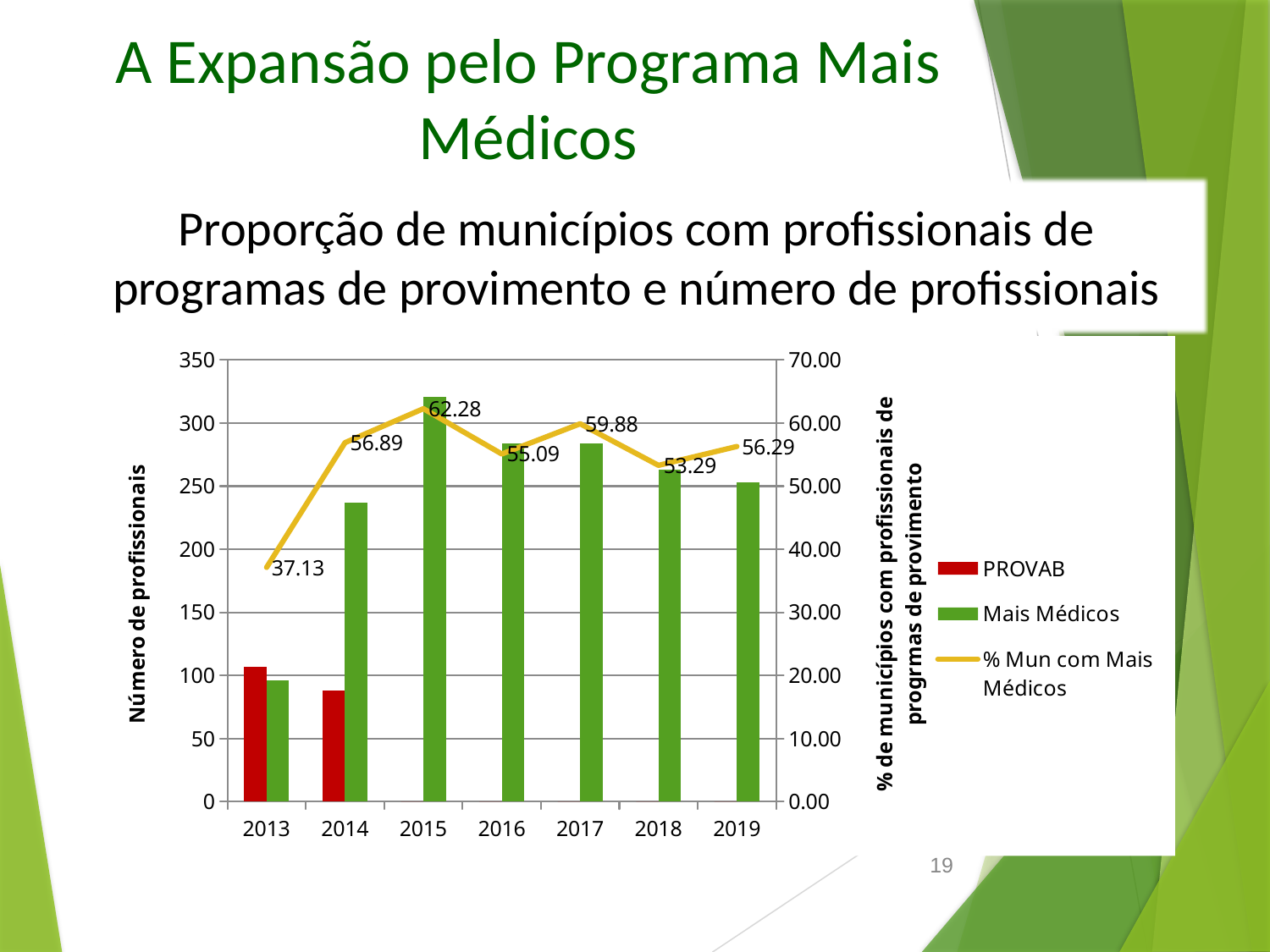
Is the Mais Médicos bar for 2014 greater or less than 250 on the left axis? less What is the value of the % Mun com Mais Médicos line for 2015? 62.28 What is the value of the % Mun com Mais Médicos line for 2013? 37.13 In which year does the % Mun com Mais Médicos line reach its highest value? 2015 What is the value of the % Mun com Mais Médicos line for 2018? 53.29 Does the % Mun com Mais Médicos line rise or fall from 2013 to 2015? rise How many series does the legend list? 3 In which year does the % Mun com Mais Médicos line have its lowest value? 2013 Which year has a higher % Mun com Mais Médicos value, 2017 or 2016? 2017 Is the Mais Médicos bar for 2015 greater or less than 300 on the left axis? greater What is the difference between the % Mun com Mais Médicos values for 2015 and 2013? 25.15 How many years are shown on the x axis? 7